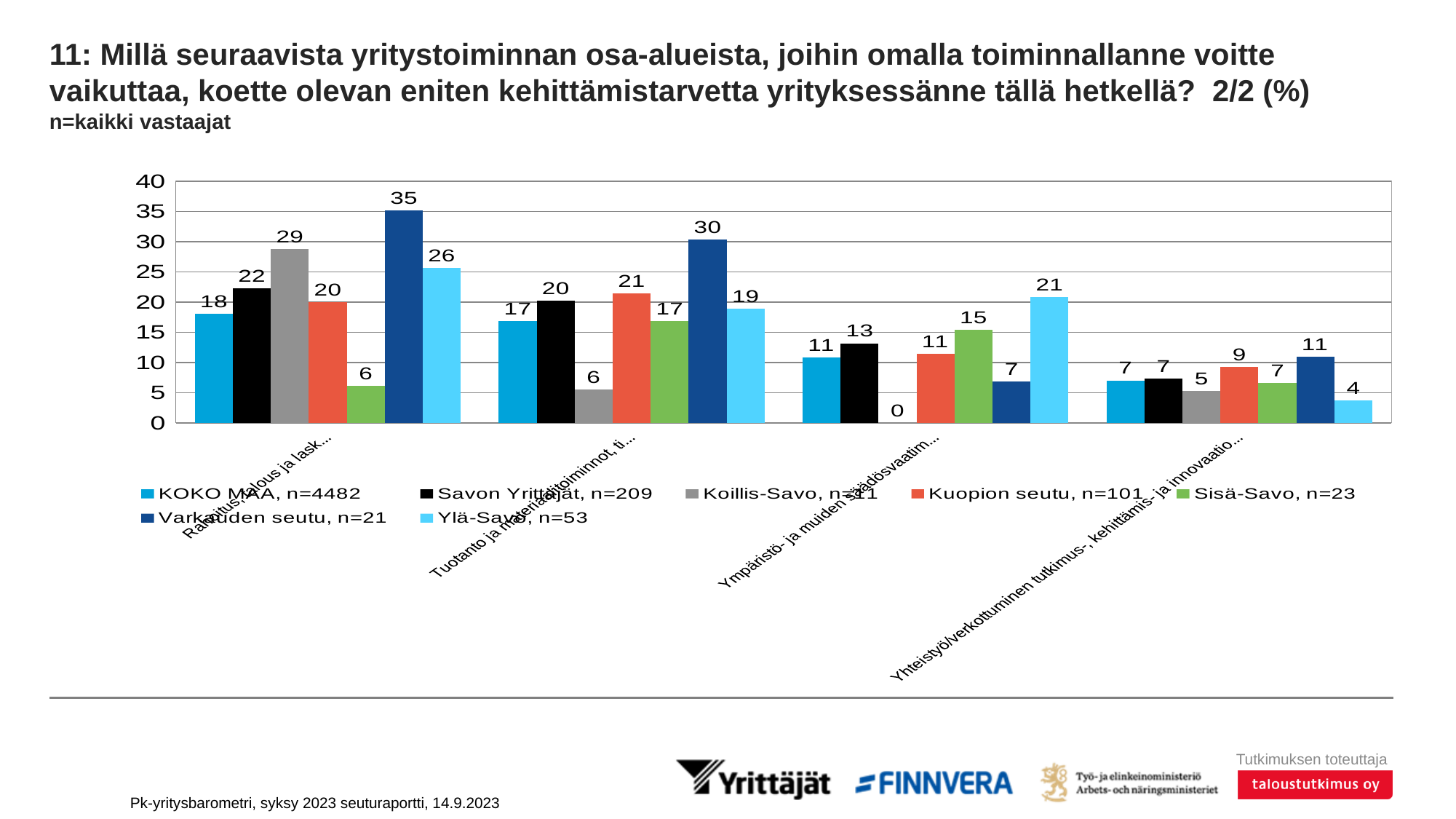
What is the value for KOKO MAA, n=4482 in the category 'Tuotanto ja materiaalitoiminnot...'? 17 Is the value for Varkauden seutu, n=21 in the category 'Tuotanto ja materiaalitoiminnot...' greater or less than 25? greater What is the value for Ylä-Savo, n=53 in the category 'Yhteistyö/verkottuminen tutkimus-, kehittämis- ja innovaatio...'? 4 Which series has the lowest value in the category 'Ympäristö- ja muiden säädösvaatim...'? Koillis-Savo, n=11 What kind of chart is shown on the slide? bar chart How many category groups are plotted along the x axis? 4 What is the value for Varkauden seutu, n=21 in the first category group (Rahoitus, talous ja lask...)? 35 What is the value for Ylä-Savo, n=53 in the category 'Ympäristö- ja muiden säädösvaatim...'? 21 Which series has the highest value in the category 'Yhteistyö/verkottuminen tutkimus-, kehittämis- ja innovaatio...'? Varkauden seutu, n=21 What is the difference between Varkauden seutu, n=21 and KOKO MAA, n=4482 in the first category group (Rahoitus, talous ja lask...)? 17 How many series does the legend list? 7 In the category 'Tuotanto ja materiaalitoiminnot...', which is larger: Kuopion seutu, n=101 or Savon Yrittäjät, n=209? Kuopion seutu, n=101